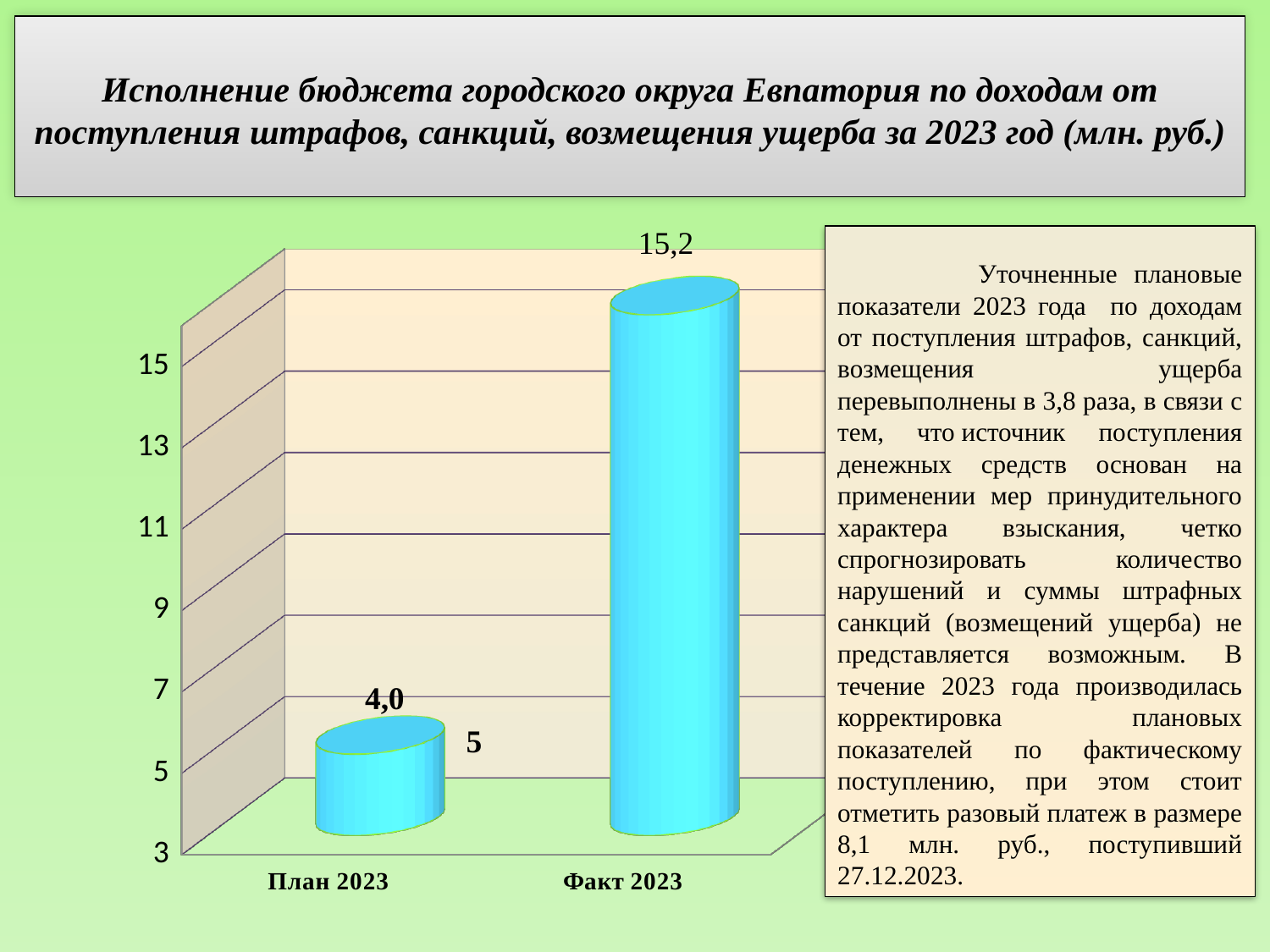
Which is larger, the value for План 2023 or the value for Факт 2023? Факт 2023 Do the values rise or fall from План 2023 to Факт 2023? rise Is the value for План 2023 greater or less than 7? less What is the difference between the values for Факт 2023 and План 2023? 11,2 Which category has the lowest value? План 2023 What unit of measurement is stated in the chart title? млн. руб. Which category has the highest value? Факт 2023 What kind of chart is shown on the slide? bar chart What is the value for План 2023? 4,0 How many categories are shown on the chart? 2 Is the value for Факт 2023 greater or less than 13? greater What is the value for Факт 2023? 15,2